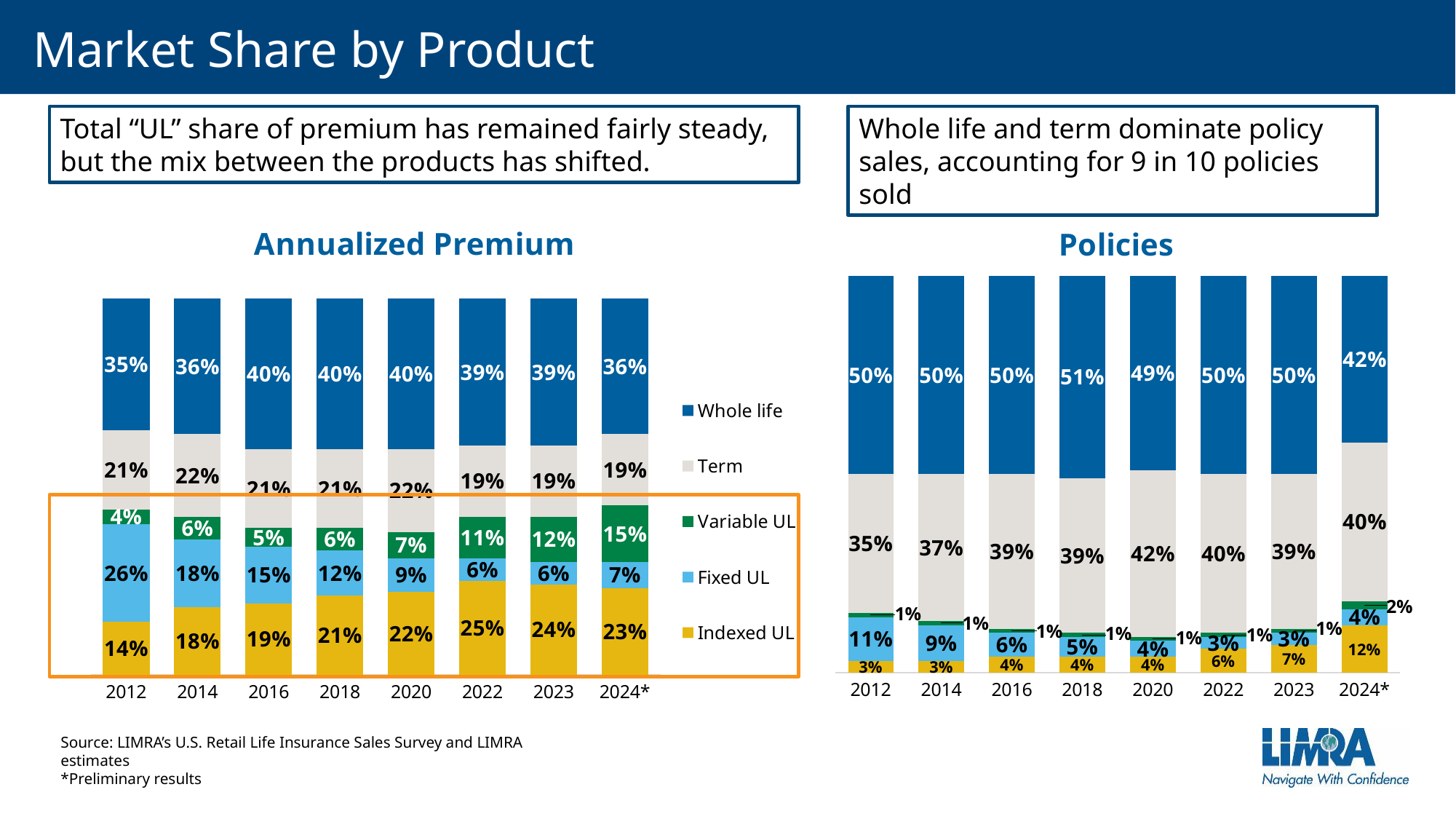
In the Policies chart, is the Whole life share in 2018 larger or the Term share in 2018? Whole life In the Policies chart, which year has the lowest Whole life share? 2024* In the Policies chart, what is the Term share in 2020? 42% In the Policies chart, what is the Indexed UL share in 2024*? 12% In the Annualized Premium chart, which year has the lowest Variable UL share? 2012 In the Annualized Premium chart, which year has the highest Indexed UL share? 2022 In the Annualized Premium chart, what is the difference between the Fixed UL share in 2012 and in 2024*? 19% What kind of chart is the Policies chart? stacked bar chart In the Annualized Premium chart, does Fixed UL share rise or fall from 2012 to 2023? fall In the Annualized Premium chart, what is the Whole life share in 2016? 40% How many series does the legend list? 5 In the Annualized Premium chart, what is the Fixed UL share in 2012? 26%